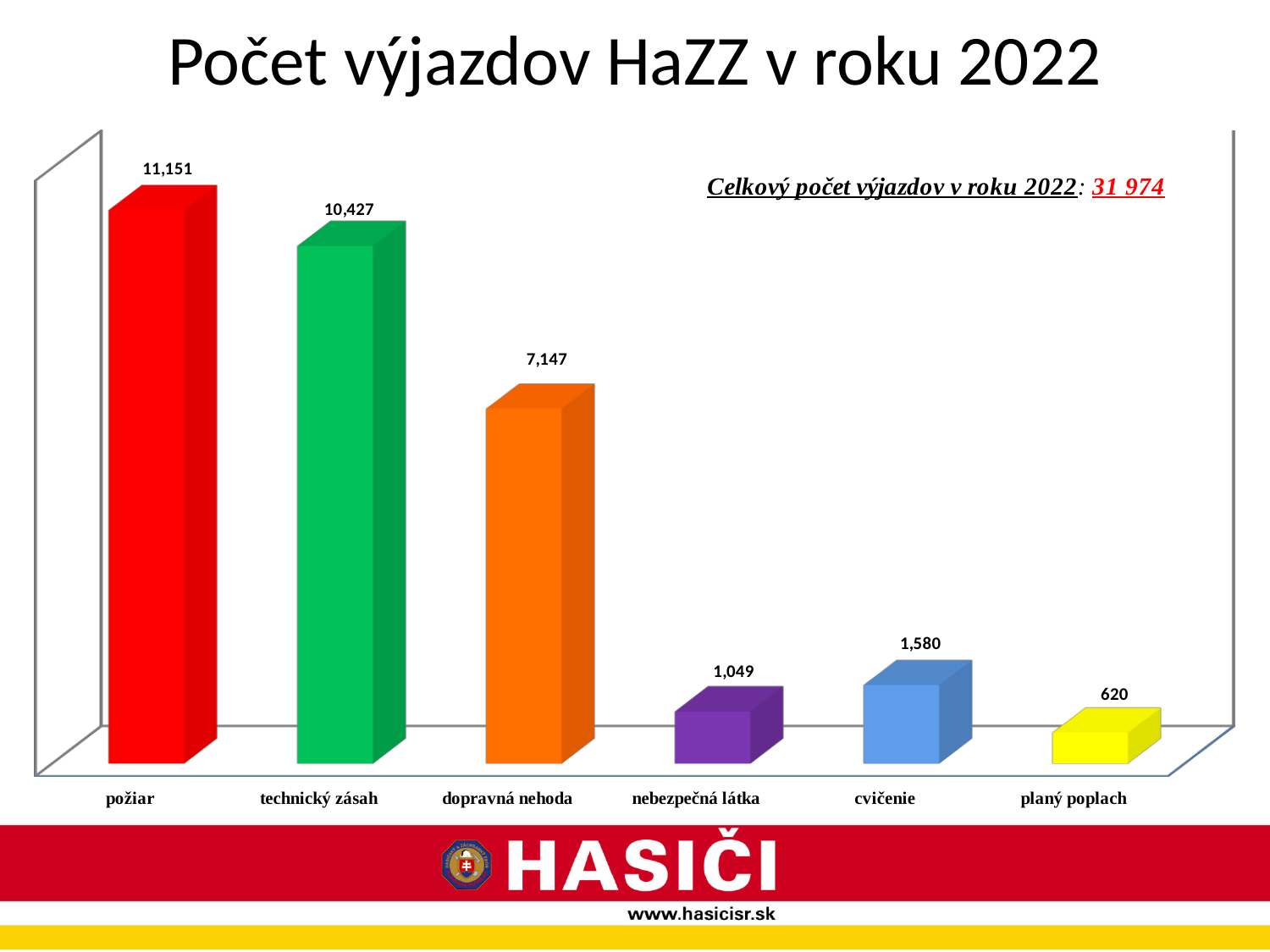
How many categories are shown in the chart? 6 What is the value for dopravná nehoda? 7,147 What is the title of the slide? Počet výjazdov HaZZ v roku 2022 What is the difference between the values for požiar and technický zásah? 724 Which category has the highest value? požiar What is the difference between the values for cvičenie and nebezpečná látka? 531 Which is larger, the value for cvičenie or the value for nebezpečná látka? cvičenie What is the value for planý poplach? 620 Which category has the lowest value? planý poplach What kind of chart is shown on the slide? bar chart What is the value for technický zásah? 10,427 What is the value for požiar? 11,151